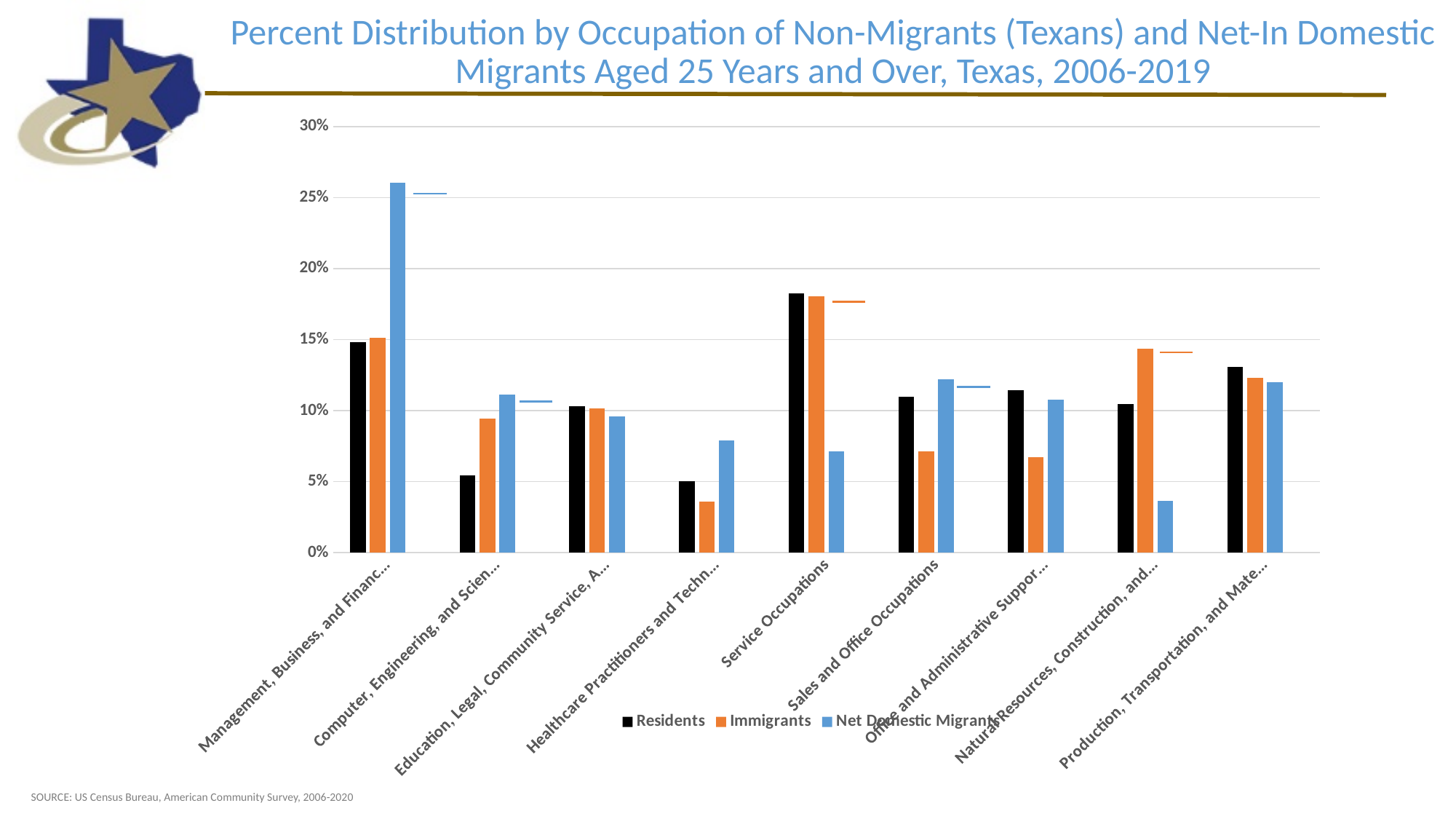
How many series does the legend list? 3 Is the Immigrants value for Sales and Office Occupations greater or less than 10%? less For Service Occupations, which series has the lowest value? Net Domestic Migrants Is the Net Domestic Migrants value for Service Occupations greater or less than 10%? less What source is cited at the bottom of the slide? US Census Bureau, American Community Survey, 2006-2020 For Sales and Office Occupations, which is larger: the Immigrants value or the Net Domestic Migrants value? Net Domestic Migrants Which occupation category has the highest value for Residents? Service Occupations What kind of chart is shown on the slide? bar chart Is the Residents value for Service Occupations greater or less than 15%? greater How many occupation categories are plotted along the x axis? 9 Which colour represents the Immigrants series in the legend? orange